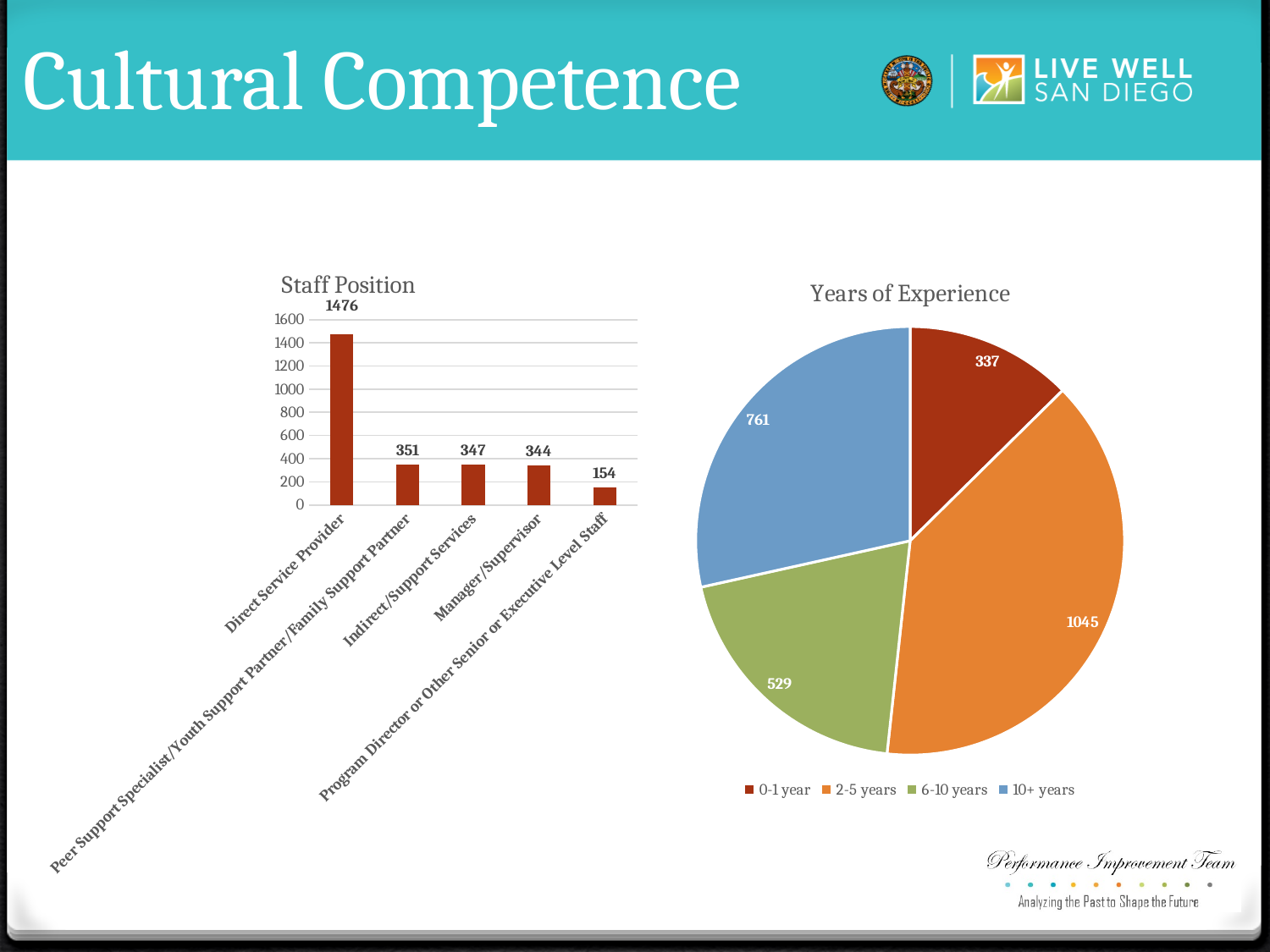
In the Staff Position chart, which staff position has the lowest value? Program Director or Other Senior or Executive Level Staff In the Staff Position chart, what is the value for Direct Service Provider? 1476 How many categories does the legend of the Years of Experience chart list? 4 In the Staff Position chart, which staff position has the highest value? Direct Service Provider In the Staff Position chart, what is the value for Manager/Supervisor? 344 In the Staff Position chart, how many staff position categories are shown? 5 What kind of chart is the Staff Position chart? Bar chart In the Years of Experience chart, which category has the smallest slice? 0-1 year In the Staff Position chart, what is the difference between Direct Service Provider and Indirect/Support Services? 1129 In the Years of Experience chart, is the value for 6-10 years larger or smaller than the value for 10+ years? Smaller In the Years of Experience chart, what is the value for 10+ years? 761 In the Years of Experience chart, what is the value for 2-5 years? 1045